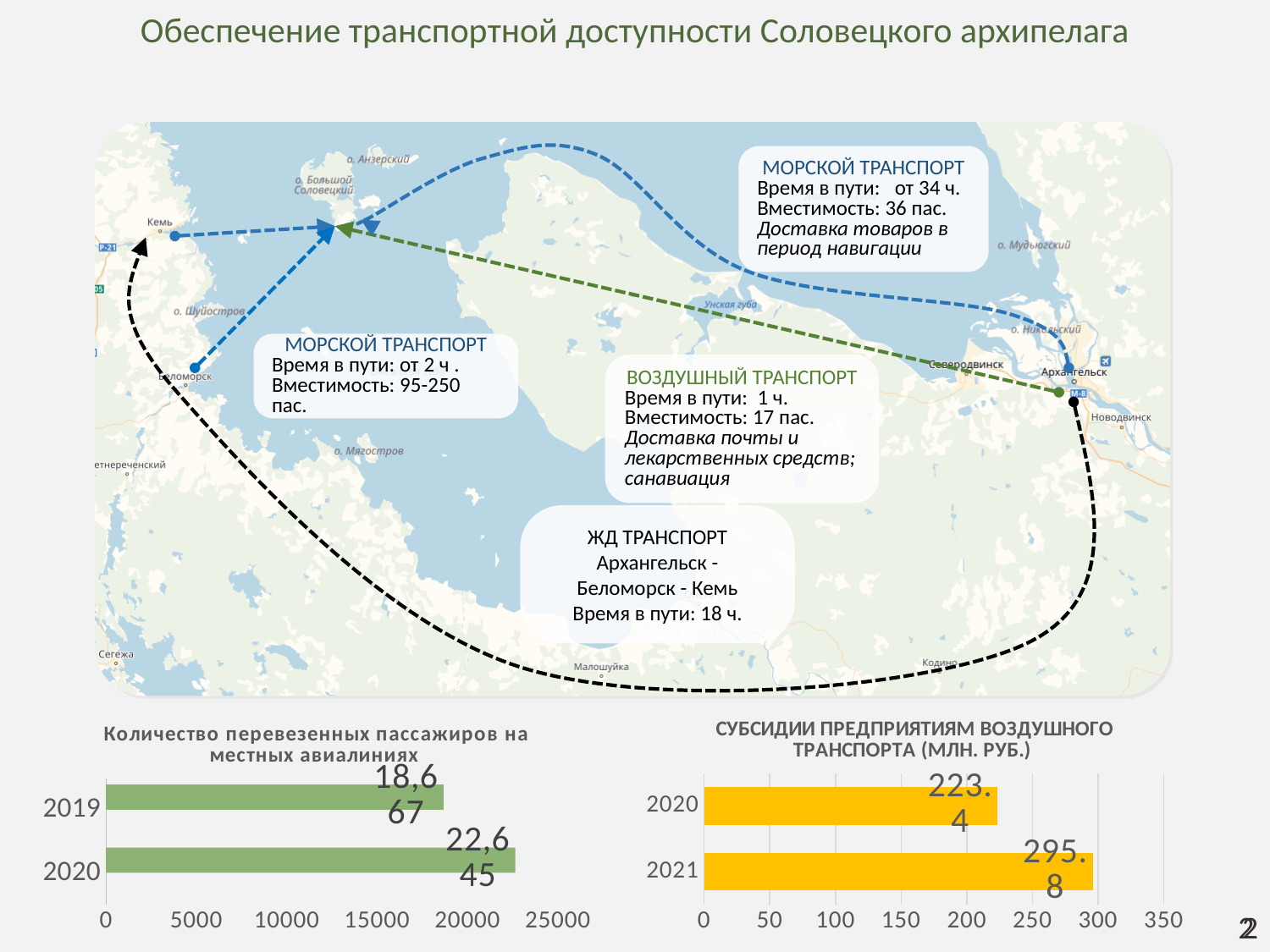
In the chart 'СУБСИДИИ ПРЕДПРИЯТИЯМ ВОЗДУШНОГО ТРАНСПОРТА (МЛН. РУБ.)', what is the value for 2020? 223.4 In the chart 'Количество перевезенных пассажиров на местных авиалиниях', what is the difference between the 2020 and 2019 values? 3,978 In the chart 'СУБСИДИИ ПРЕДПРИЯТИЯМ ВОЗДУШНОГО ТРАНСПОРТА (МЛН. РУБ.)', what is the value for 2021? 295.8 In the chart 'Количество перевезенных пассажиров на местных авиалиниях', what is the value for 2019? 18,667 In the chart 'Количество перевезенных пассажиров на местных авиалиниях', is the value for 2019 greater or less than 20000? less In the chart 'СУБСИДИИ ПРЕДПРИЯТИЯМ ВОЗДУШНОГО ТРАНСПОРТА (МЛН. РУБ.)', is the value for 2021 greater or less than 250? greater In the chart 'СУБСИДИИ ПРЕДПРИЯТИЯМ ВОЗДУШНОГО ТРАНСПОРТА (МЛН. РУБ.)', what is the difference between the 2021 and 2020 values? 72.4 In the chart 'Количество перевезенных пассажиров на местных авиалиниях', which year has the higher value? 2020 What kind of chart is 'Количество перевезенных пассажиров на местных авиалиниях'? bar chart In the chart 'СУБСИДИИ ПРЕДПРИЯТИЯМ ВОЗДУШНОГО ТРАНСПОРТА (МЛН. РУБ.)', which year has the lower value? 2020 In the chart 'СУБСИДИИ ПРЕДПРИЯТИЯМ ВОЗДУШНОГО ТРАНСПОРТА (МЛН. РУБ.)', how many years are shown? 2 In the chart 'Количество перевезенных пассажиров на местных авиалиниях', what is the value for 2020? 22,645